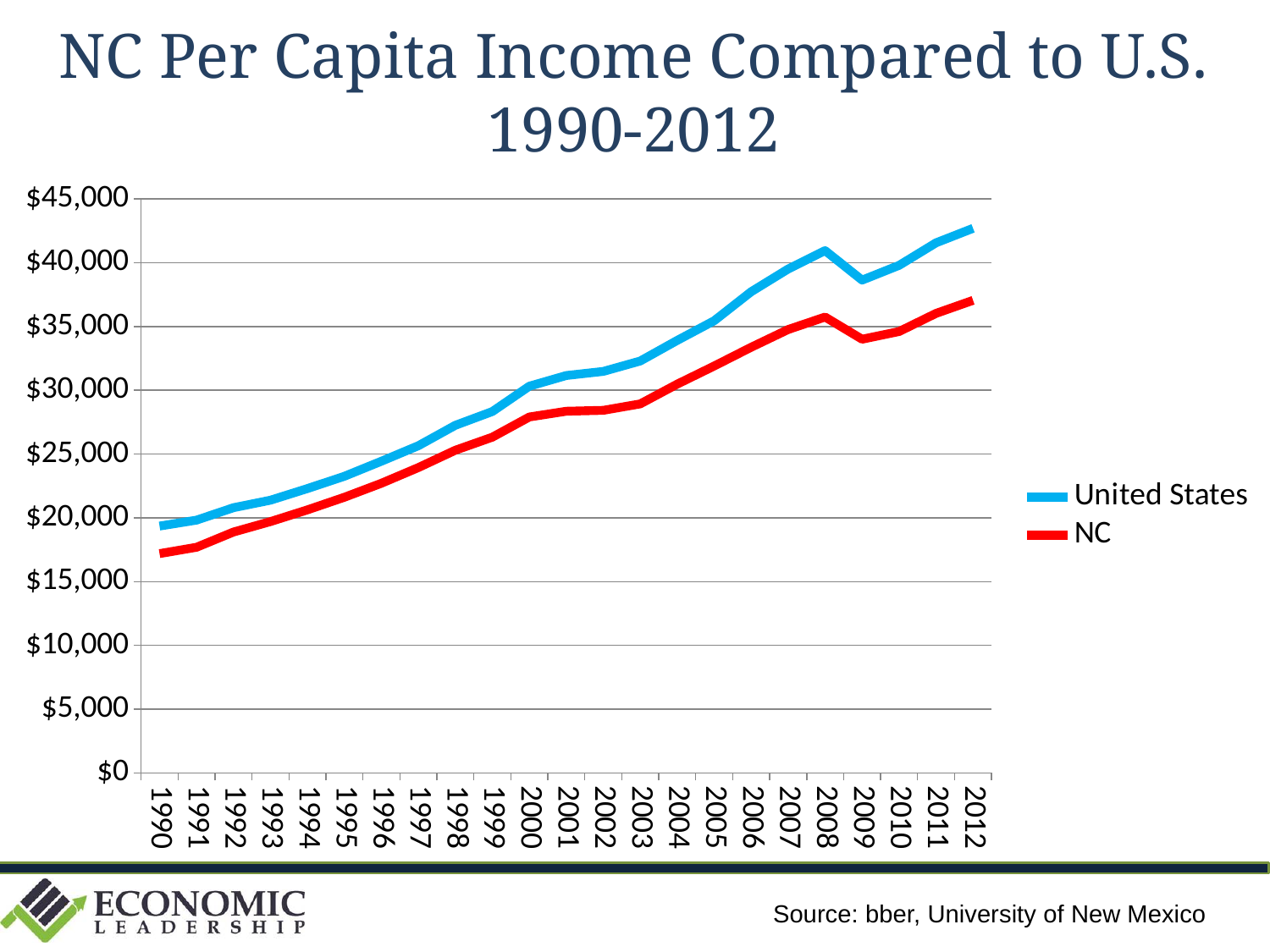
In which year is the NC value lowest? 1990 Between 2008 and 2009, did the United States value rise or fall? fall Is the value for NC in 2012 greater or less than $35,000? greater How many series does the legend list? 2 What colour is the NC line? red Overall, do the values rise or fall from 1990 to 2012? rise In 2012, which series has the higher value, United States or NC? United States How many years are plotted along the x axis? 23 Is the value for NC in 1990 greater or less than $20,000? less Is the value for United States in 2012 greater or less than $40,000? greater What kind of chart is shown on the slide? line chart